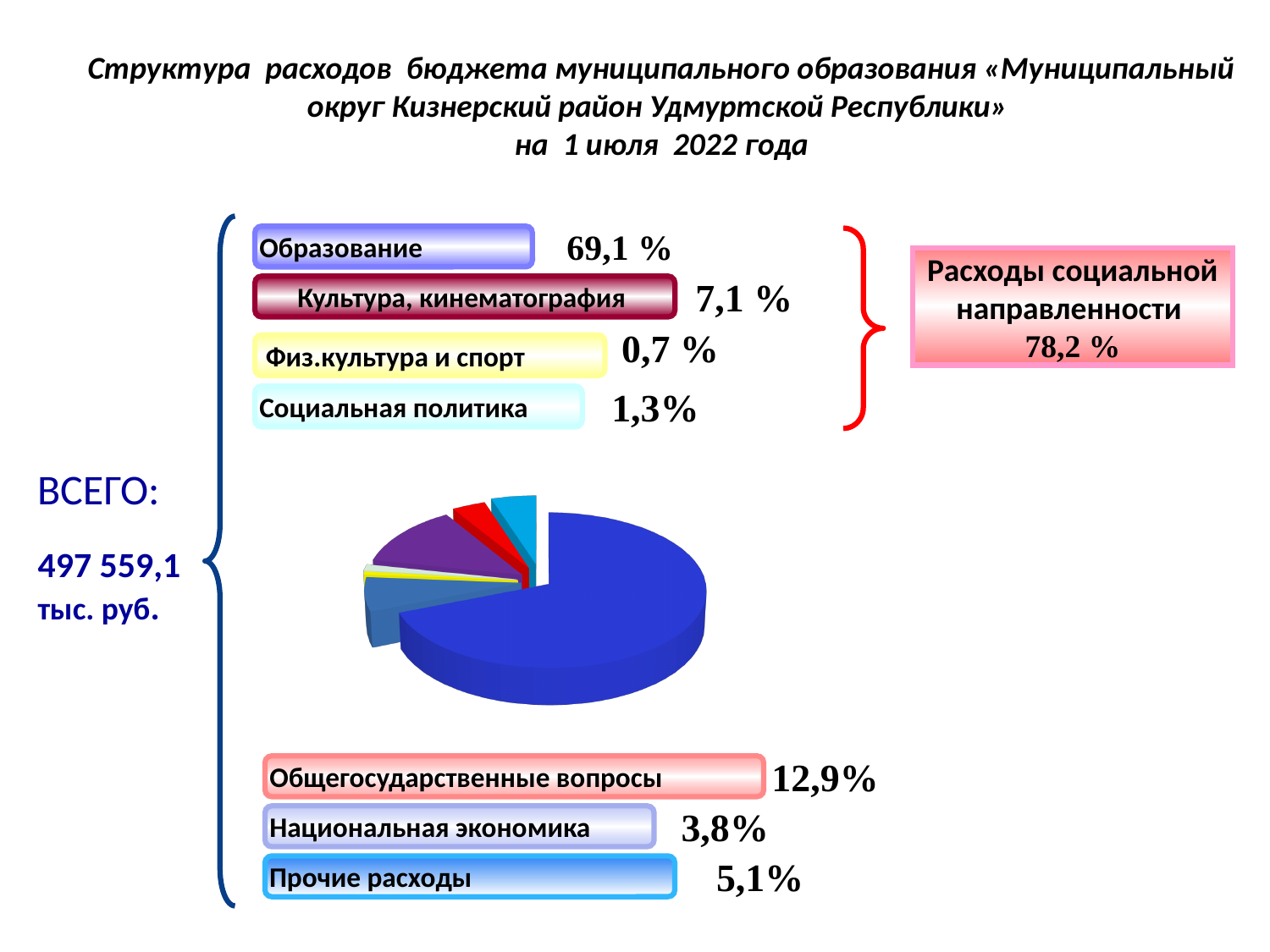
How many expenditure categories are listed around the pie chart? 7 Which expenditure category has the largest share? Образование What kind of chart is shown on the slide? pie chart What is the value shown for Культура, кинематография? 7,1 % Which is larger: the share for Культура, кинематография or for Прочие расходы? Культура, кинематография Which expenditure category has the smallest share? Физ.культура и спорт What is the value shown for Общегосударственные вопросы? 12,9% What is the value shown for Национальная экономика? 3,8% What is the total amount of budget expenditures (ВСЕГО) shown on the slide? 497 559,1 тыс. руб. What share of budget expenditures does Образование account for? 69,1 % What is the difference in percentage points between Образование and Общегосударственные вопросы? 56,2 What share is given for Расходы социальной направленности? 78,2 %